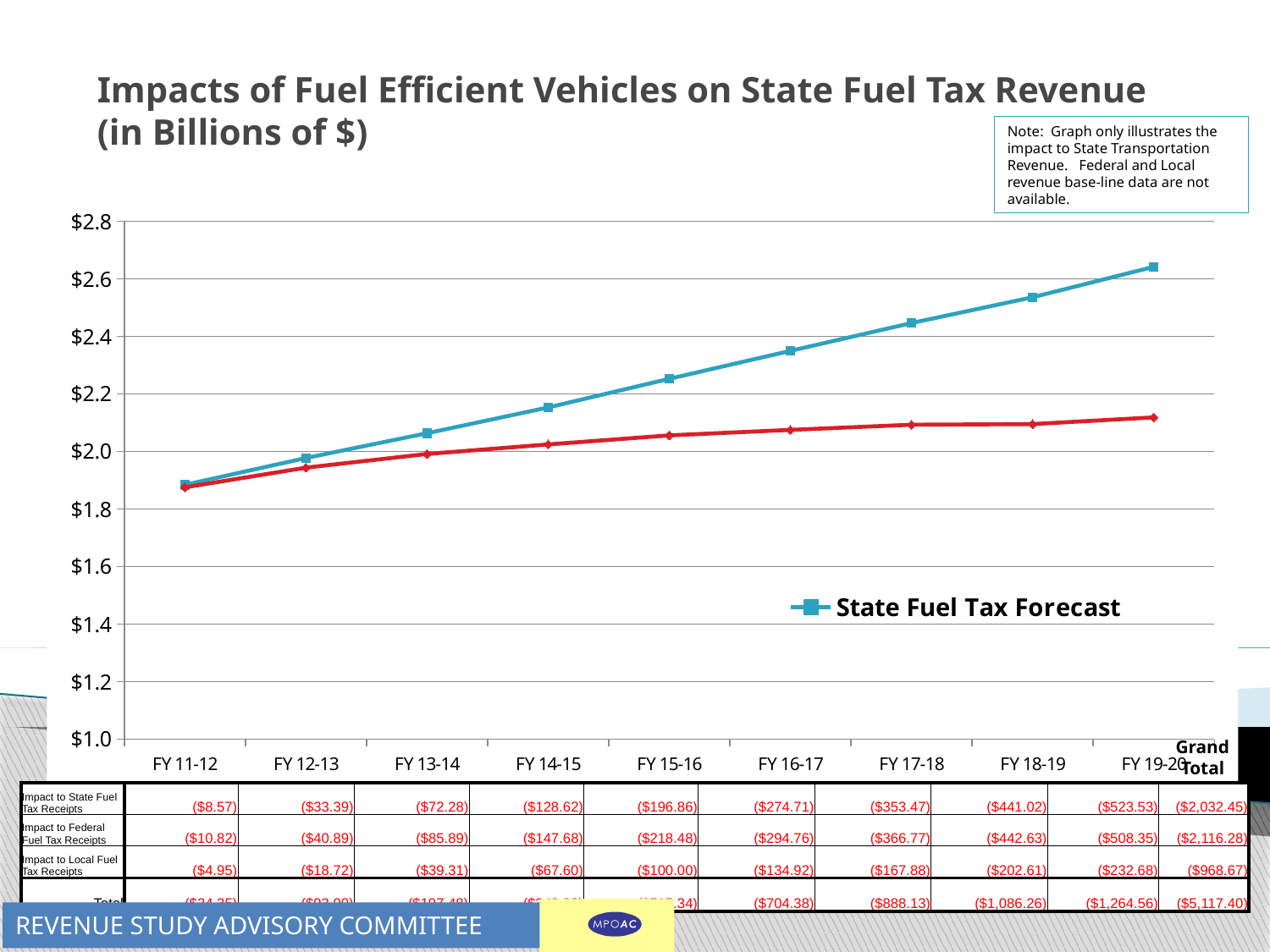
What kind of chart is shown on the slide? line chart What is the name of the series listed in the chart's legend? State Fuel Tax Forecast At FY 19-20, which line is higher: the blue State Fuel Tax Forecast line or the red line? the blue State Fuel Tax Forecast line Does the State Fuel Tax Forecast line rise or fall from FY 11-12 to FY 19-20? rise Is the State Fuel Tax Forecast value for FY 11-12 greater or less than $2.0? less How many fiscal years are plotted along the x axis of the chart? 9 Is the red line's value for FY 19-20 greater or less than $2.2? less Is the State Fuel Tax Forecast value for FY 16-17 greater or less than $2.2? greater In which fiscal year is the State Fuel Tax Forecast line at its highest? FY 19-20 In which fiscal year is the State Fuel Tax Forecast line at its lowest? FY 11-12 How many series does the chart's legend list? 1